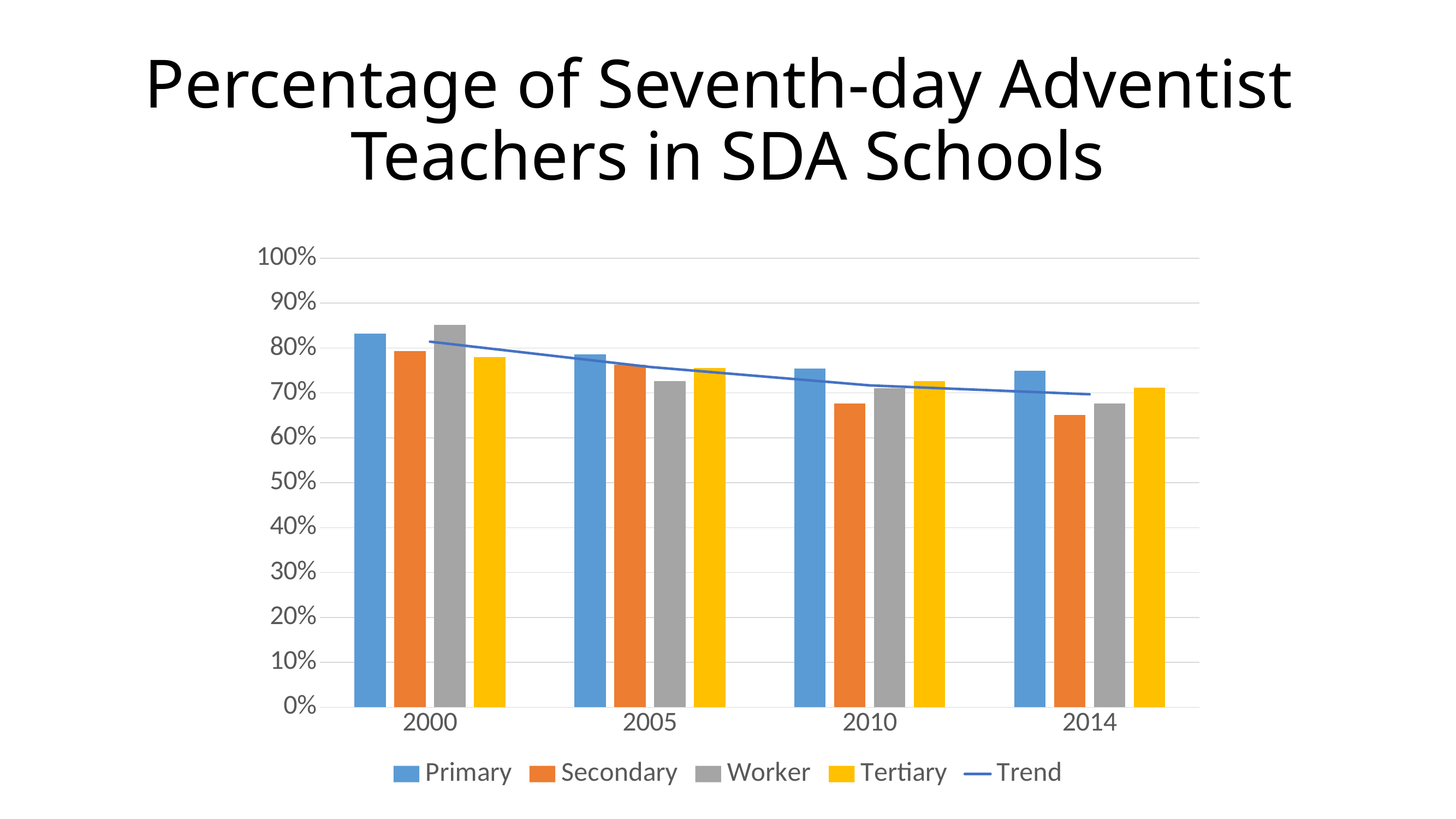
Is the value for Primary in 2000 greater or less than 80%? greater In 2000, which series has the highest value? Worker How many years are shown on the x axis? 4 Is the value for Worker in 2000 greater or less than 80%? greater How many entries does the legend list? 5 Is the value for Tertiary in 2010 greater or less than 70%? greater In 2014, which series has the lowest value? Secondary In 2005, which is larger, Primary or Worker? Primary What kind of chart is shown on the slide? combination bar and line chart What is the legend label of the line plotted across the bars? Trend Do the Secondary values rise or fall from 2000 to 2014? fall